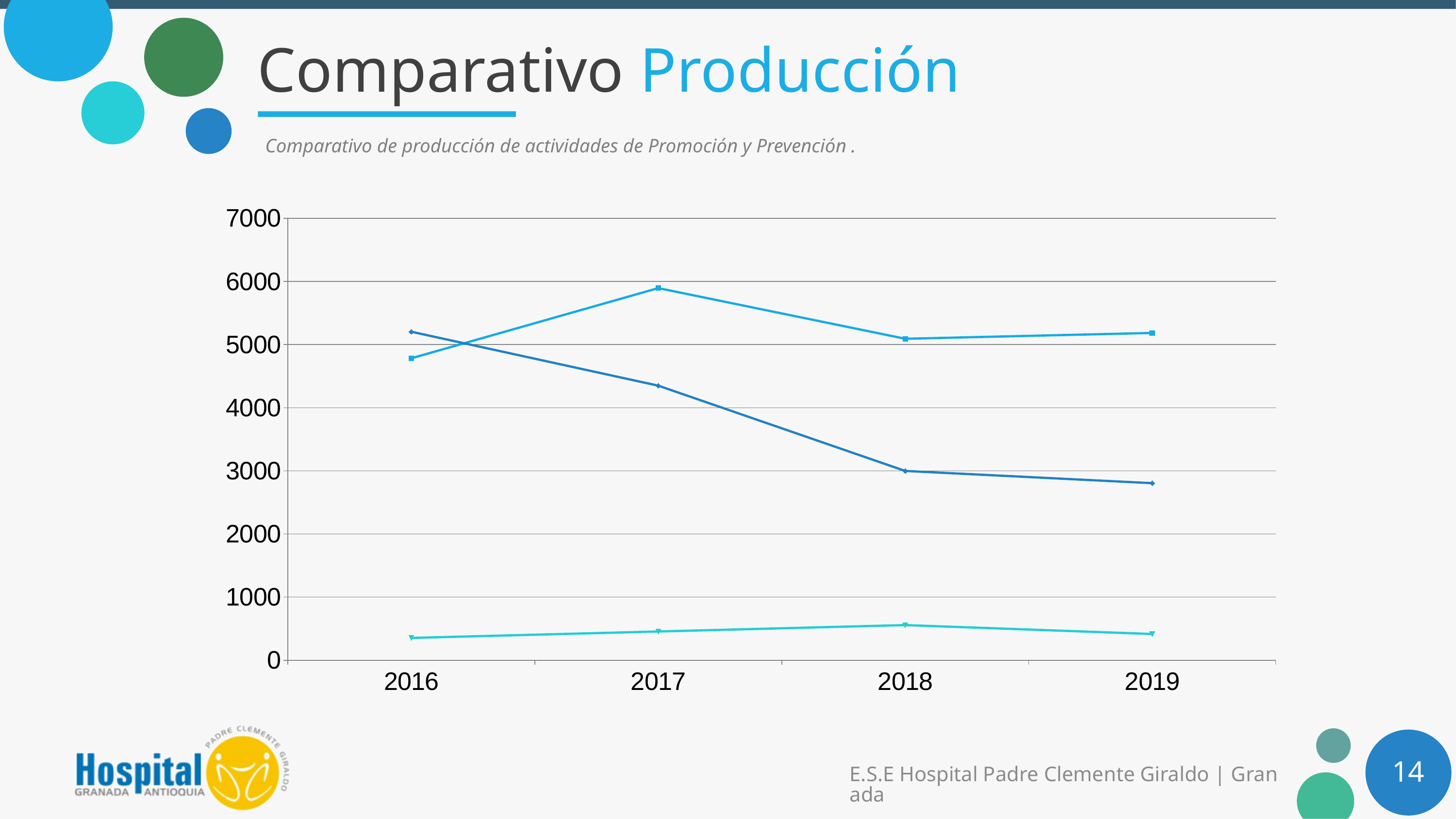
How many years are shown on the x axis of the chart? 4 Is the value of the light blue line with square markers in 2016 greater or less than 5000? less In which year does the light blue line with square markers reach its highest value? 2017 Is the value of the dark blue line with diamond markers in 2016 greater or less than 5000? greater In 2019, which line is higher: the dark blue line with diamond markers or the light blue line with square markers? the light blue line with square markers Is the value of the dark blue line with diamond markers in 2017 greater or less than 4000? greater In which year does the dark blue line with diamond markers reach its highest value? 2016 Does the dark blue line with diamond markers rise or fall from 2016 to 2019? fall What kind of chart is shown on the slide? line chart How many lines are plotted on the chart? 3